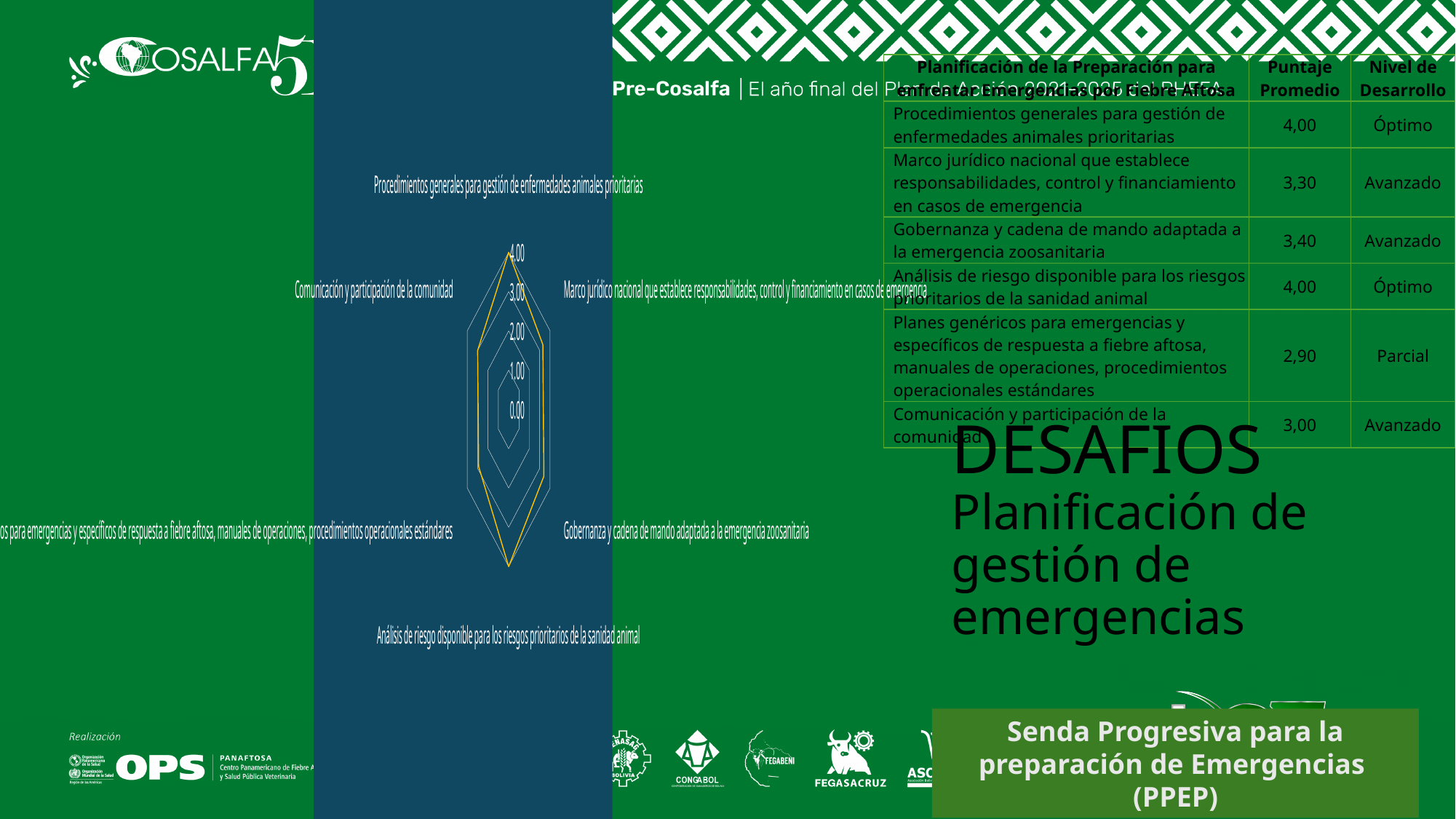
What Nivel de Desarrollo is assigned to 'Planes genéricos para emergencias y específicos de respuesta a fiebre aftosa'? Parcial What is the difference between the Puntaje Promedio of 'Procedimientos generales para gestión de enfermedades animales prioritarias' and 'Planes genéricos para emergencias y específicos de respuesta a fiebre aftosa'? 1,10 What kind of chart is shown on the left of the slide? Radar chart What is the highest value shown on the radar chart's axis scale? 4,00 What is the Puntaje Promedio for 'Gobernanza y cadena de mando adaptada a la emergencia zoosanitaria'? 3,40 Is the value for 'Marco jurídico nacional que establece responsabilidades, control y financiamiento en casos de emergencia' greater or less than 3,00? greater Which category has the lowest Puntaje Promedio? Planes genéricos para emergencias y específicos de respuesta a fiebre aftosa, manuales de operaciones, procedimientos operacionales estándares Which has a higher Puntaje Promedio: 'Procedimientos generales para gestión de enfermedades animales prioritarias' or 'Planes genéricos para emergencias y específicos de respuesta a fiebre aftosa'? Procedimientos generales para gestión de enfermedades animales prioritarias What is the Puntaje Promedio for 'Análisis de riesgo disponible para los riesgos prioritarios de la sanidad animal'? 4,00 How many categories (axes) does the radar chart have? 6 What is the Puntaje Promedio for 'Procedimientos generales para gestión de enfermedades animales prioritarias'? 4,00 What is the Puntaje Promedio for 'Comunicación y participación de la comunidad'? 3,00